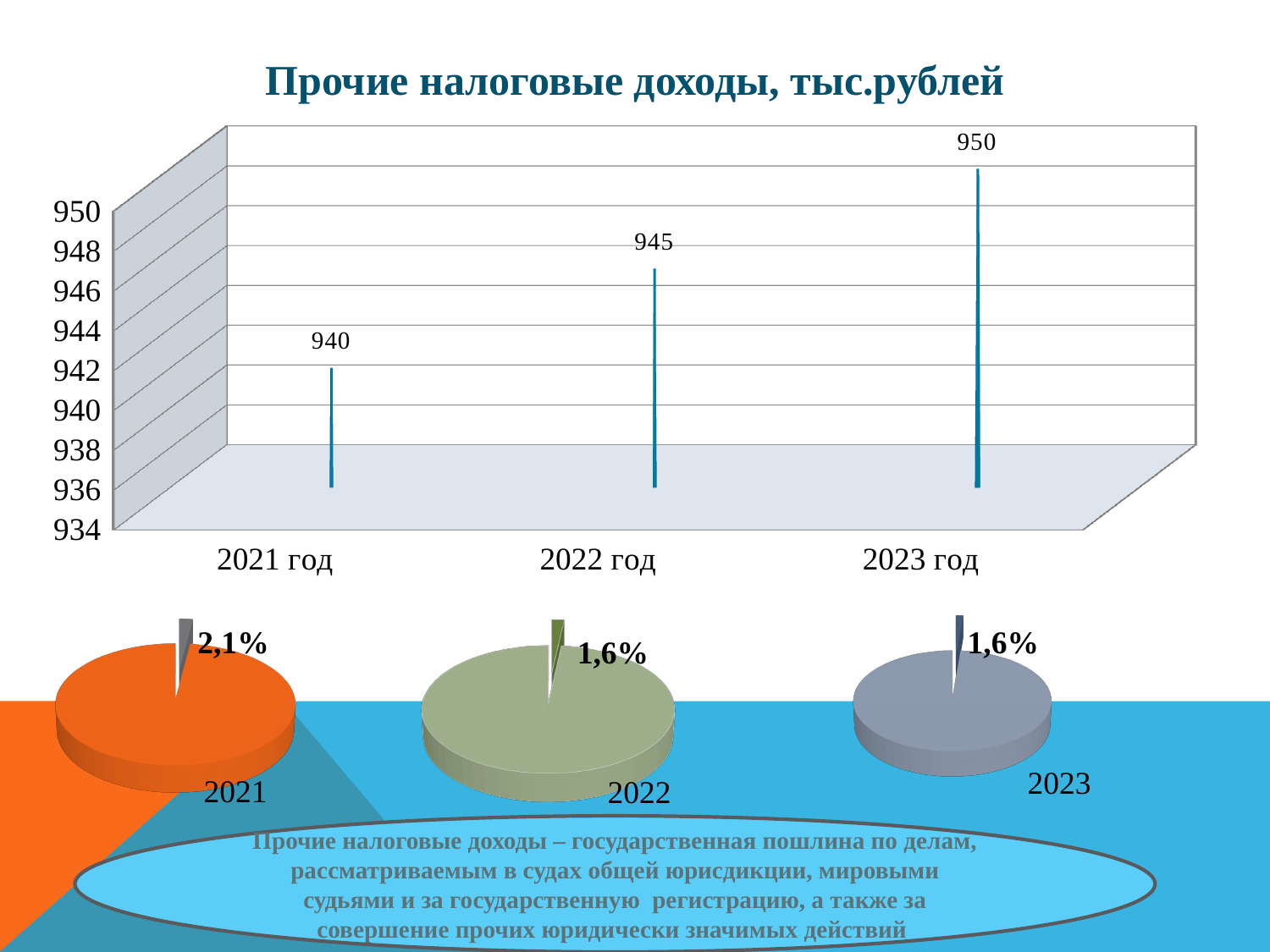
In the bar chart 'Прочие налоговые доходы, тыс.рублей', what is the value for 2021 год? 940 In the bar chart 'Прочие налоговые доходы, тыс.рублей', do the values rise or fall from 2021 год to 2023 год? rise What kind of chart is the top chart titled 'Прочие налоговые доходы, тыс.рублей'? bar chart In the bar chart 'Прочие налоговые доходы, тыс.рублей', what is the difference between the values for 2023 год and 2021 год? 10 In the bar chart 'Прочие налоговые доходы, тыс.рублей', which year has the lowest value? 2021 год In the pie chart labelled 2023 at the bottom right of the slide, what share is shown for the small slice? 1,6% In the bar chart 'Прочие налоговые доходы, тыс.рублей', which year has the highest value? 2023 год In the bar chart 'Прочие налоговые доходы, тыс.рублей', which is larger, the value for 2022 год or 2021 год? 2022 год In the pie chart labelled 2021 at the bottom left of the slide, what share is shown for the small slice? 2,1% How many categories are shown in the bar chart 'Прочие налоговые доходы, тыс.рублей'? 3 In the bar chart 'Прочие налоговые доходы, тыс.рублей', what is the value for 2022 год? 945 In the bar chart 'Прочие налоговые доходы, тыс.рублей', what is the value for 2023 год? 950